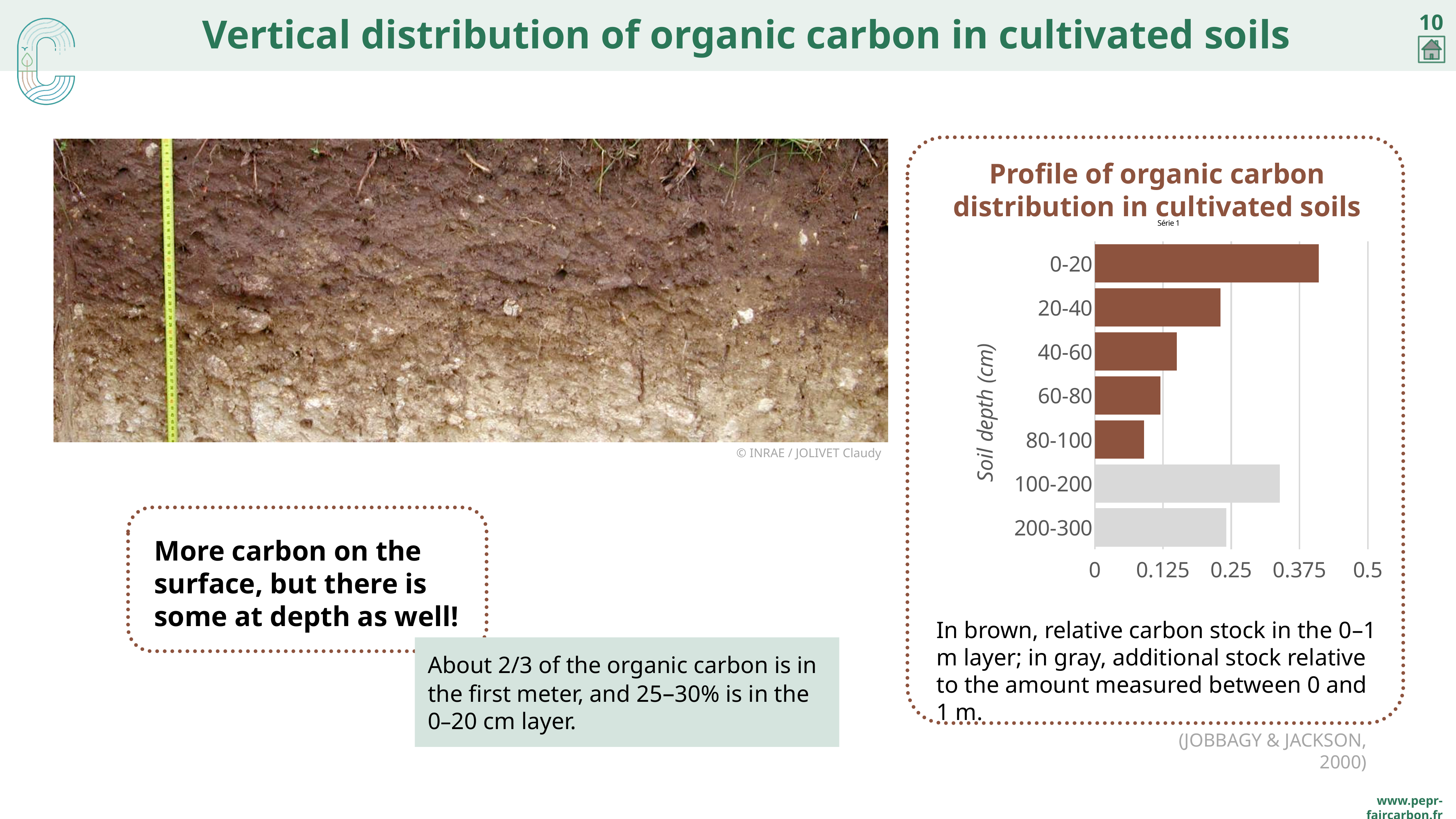
Is the value for the 0-20 cm layer greater or less than 0.25? greater Which has the larger value, the 20-40 cm layer or the 60-80 cm layer? 20-40 Which soil depth category has the shortest bar in the chart? 80-100 Among the brown bars (0-20 through 80-100), do the values rise or fall as soil depth increases? fall How many soil depth categories are plotted in the chart? 7 What is the label on the vertical axis of the chart? Soil depth (cm) Is the value for the 100-200 cm layer greater or less than 0.25? greater Is the value for the 200-300 cm layer greater or less than 0.125? greater What kind of chart is shown in the 'Profile of organic carbon distribution in cultivated soils' panel? bar chart Which soil depth category has the longest bar in the chart? 0-20